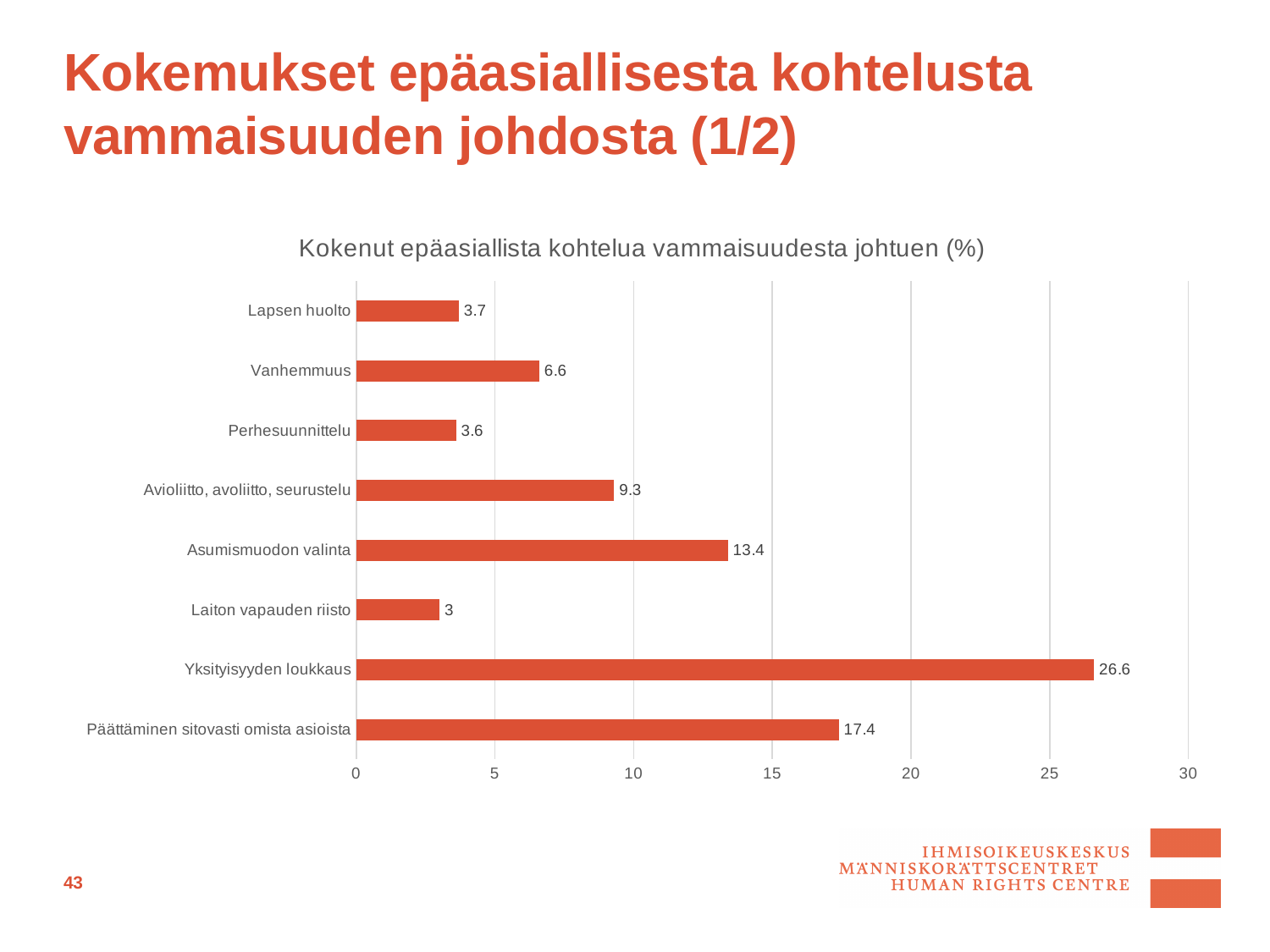
Which category has the highest value? Yksityisyyden loukkaus What type of chart is shown on the slide? bar chart What is the title of the chart? Kokenut epäasiallista kohtelua vammaisuudesta johtuen (%) What is the difference between the values for Asumismuodon valinta and Avioliitto, avoliitto, seurustelu? 4.1 Which is larger, the value for Vanhemmuus or the value for Avioliitto, avoliitto, seurustelu? Avioliitto, avoliitto, seurustelu How many categories are shown in the chart? 8 Is the value for Päättäminen sitovasti omista asioista greater or less than 15? greater What is the value for Laiton vapauden riisto? 3 What is the value for Yksityisyyden loukkaus? 26.6 What is the value for Päättäminen sitovasti omista asioista? 17.4 What is the difference between the values for Yksityisyyden loukkaus and Päättäminen sitovasti omista asioista? 9.2 What is the value for Asumismuodon valinta? 13.4